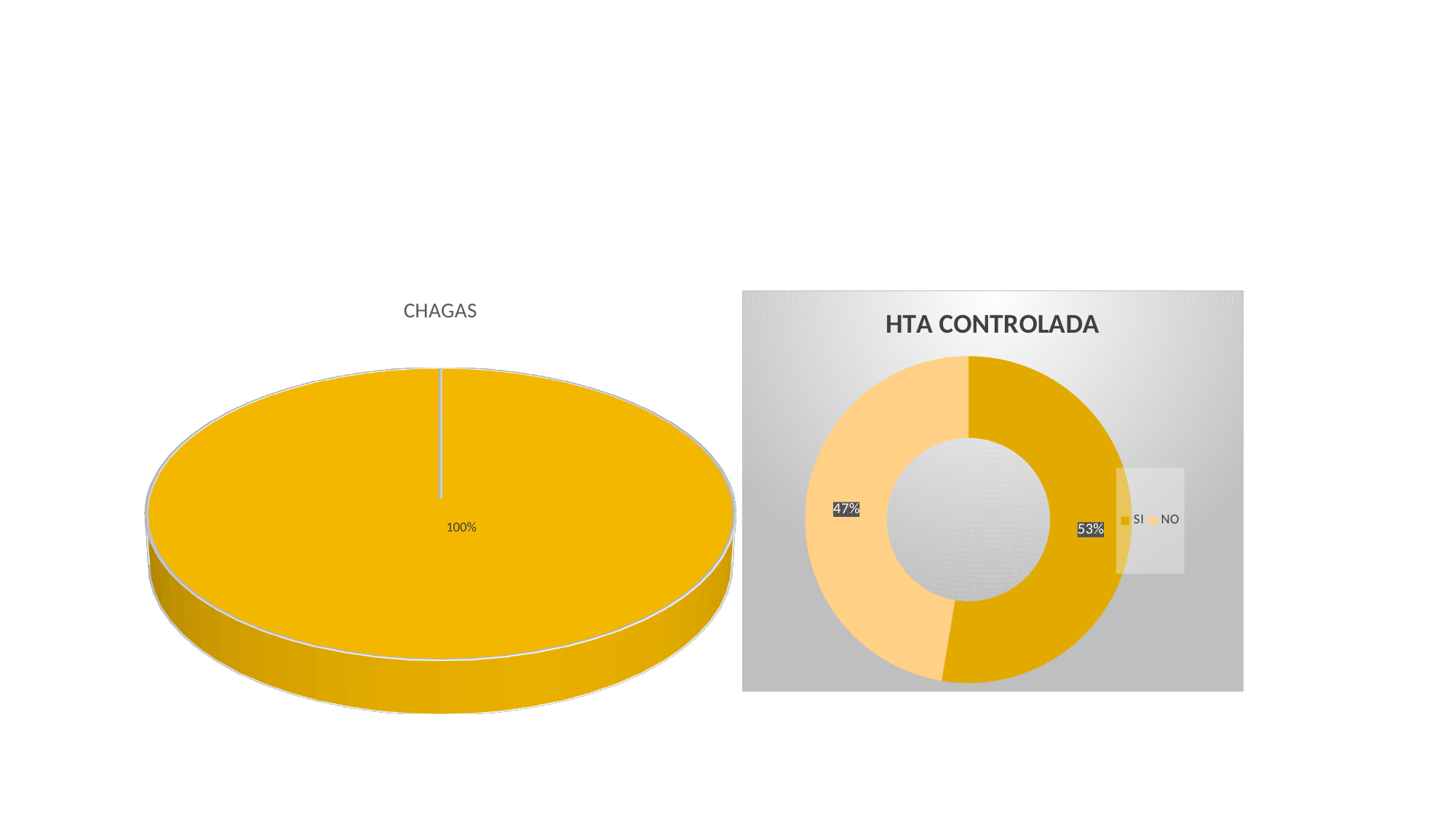
In the HTA CONTROLADA chart, what percentage is shown for NO? 47% In the HTA CONTROLADA chart, what percentage is shown for SI? 53% In the HTA CONTROLADA chart, what share of the whole does the SI slice represent? 53% What kind of chart is the CHAGAS chart on the left? pie chart What percentage is labelled on the CHAGAS pie chart? 100% In the HTA CONTROLADA chart, which category is drawn in the lighter orange colour? NO What kind of chart is the HTA CONTROLADA chart? doughnut chart How many categories does the legend of the HTA CONTROLADA chart list? 2 In the HTA CONTROLADA chart, what is the difference in percentage points between SI and NO? 6 percentage points In the HTA CONTROLADA chart, which category has the smaller share? NO In the HTA CONTROLADA chart, which category has the larger share? SI In the HTA CONTROLADA chart, is the share for NO larger or smaller than the share for SI? smaller